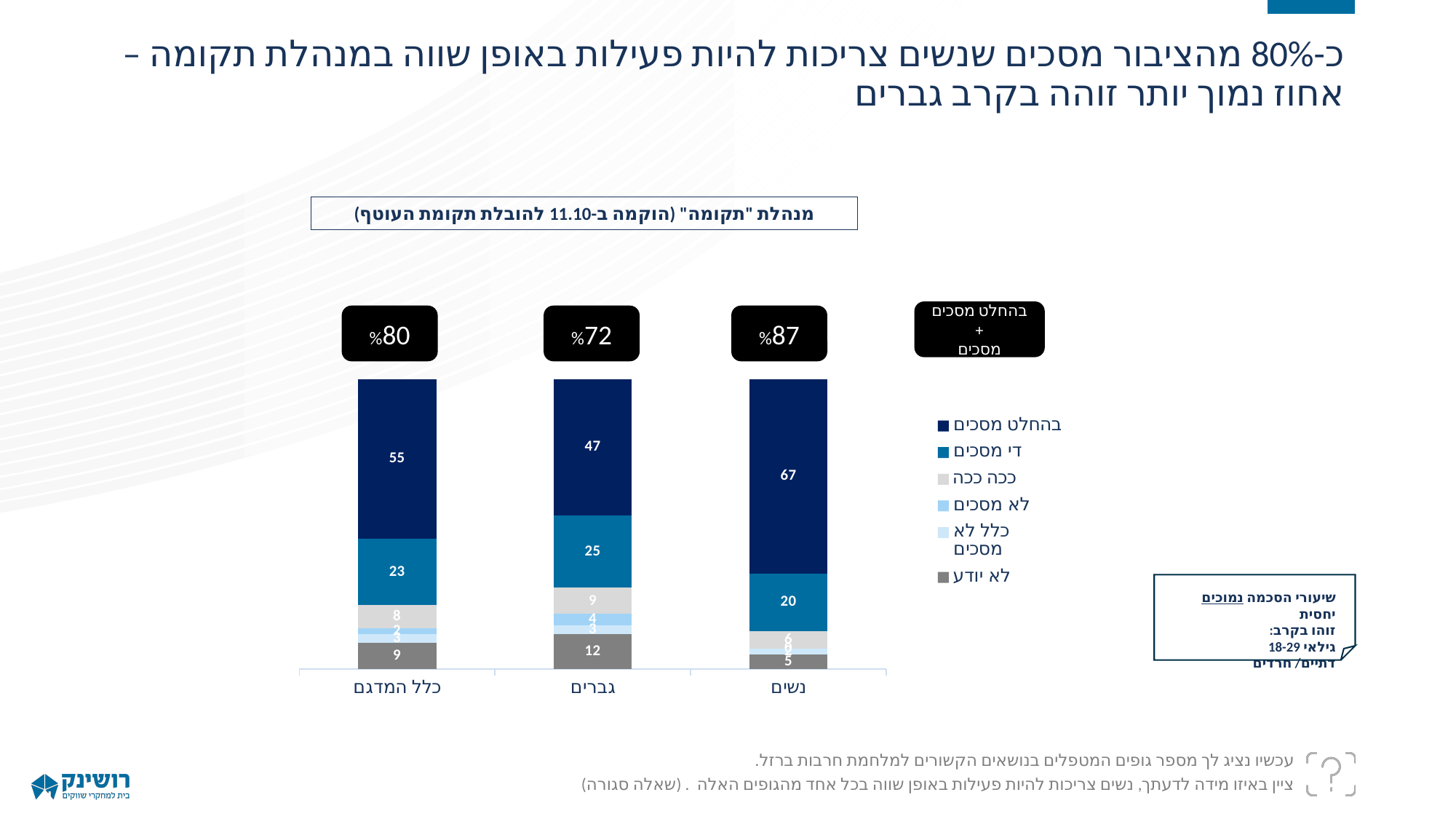
What combined percentage (בהחלט מסכים + מסכים) is shown above the bar for נשים? 87% What is the value of בהחלט מסכים for נשים? 67 What is the value of לא יודע for גברים? 12 What is the value of די מסכים for כלל המדגם? 23 What kind of chart is shown on the slide? stacked bar chart How many series does the chart legend list? 6 What is the value of בהחלט מסכים for גברים? 47 What is the difference between the בהחלט מסכים values for נשים and גברים? 20 Which category has the highest value for בהחלט מסכים? נשים Which category has the lowest combined percentage shown above its bar? גברים Which is larger: די מסכים for גברים or די מסכים for נשים? גברים How many categories are shown on the x axis of the chart? 3